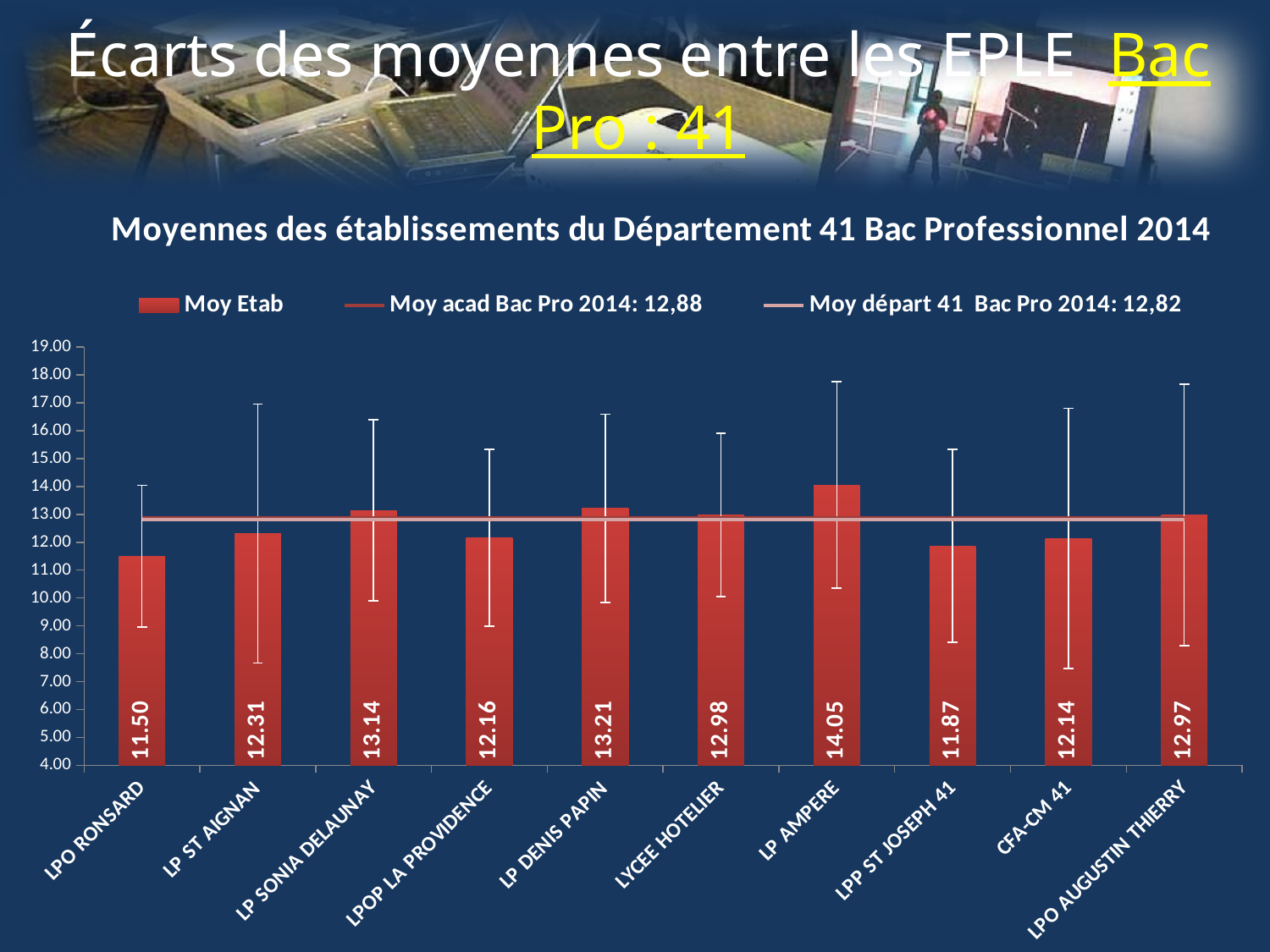
Which establishment has the highest value? LP AMPERE Which establishment has the lowest value? LPO RONSARD What kind of chart is shown? combination bar and line chart What is the value for LPO RONSARD? 11.50 Is the value for LPP ST JOSEPH 41 greater or less than 12.00? less How many establishments are shown on the x axis? 10 What is the difference between the values for LP AMPERE and LPO RONSARD? 2.55 What is the value for CFA-CM 41? 12.14 Which is larger, the value for LP ST AIGNAN or the value for LPOP LA PROVIDENCE? LP ST AIGNAN How many series does the legend list? 3 What is the value for LP DENIS PAPIN? 13.21 According to the legend, what is the value of 'Moy acad Bac Pro 2014'? 12,88